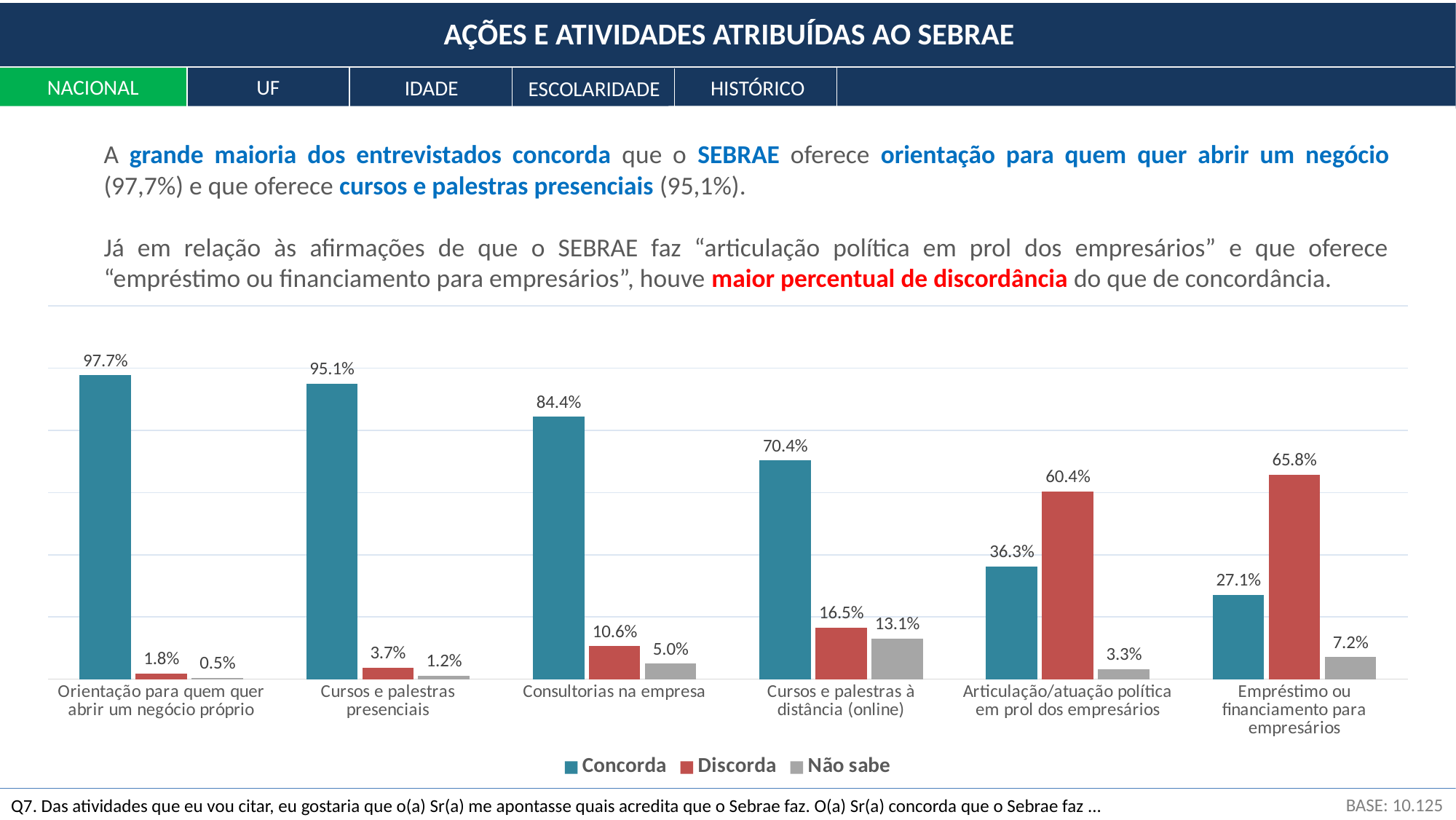
How many series does the legend list? 3 For Empréstimo ou financiamento para empresários, which is larger: Concorda or Discorda? Discorda What is the Discorda value for Articulação/atuação política em prol dos empresários? 60.4% What is the difference between the Concorda values for Orientação para quem quer abrir um negócio próprio and Cursos e palestras presenciais? 2.6% How many categories are shown on the x axis? 6 Which category has the highest Concorda value? Orientação para quem quer abrir um negócio próprio What is the Não sabe value for Cursos e palestras à distância (online)? 13.1% What kind of chart is shown on the slide? Bar chart What is the Concorda value for Consultorias na empresa? 84.4% Which category has the highest Discorda value? Empréstimo ou financiamento para empresários What are the three series listed in the legend? Concorda, Discorda, Não sabe Which category has the lowest Concorda value? Empréstimo ou financiamento para empresários